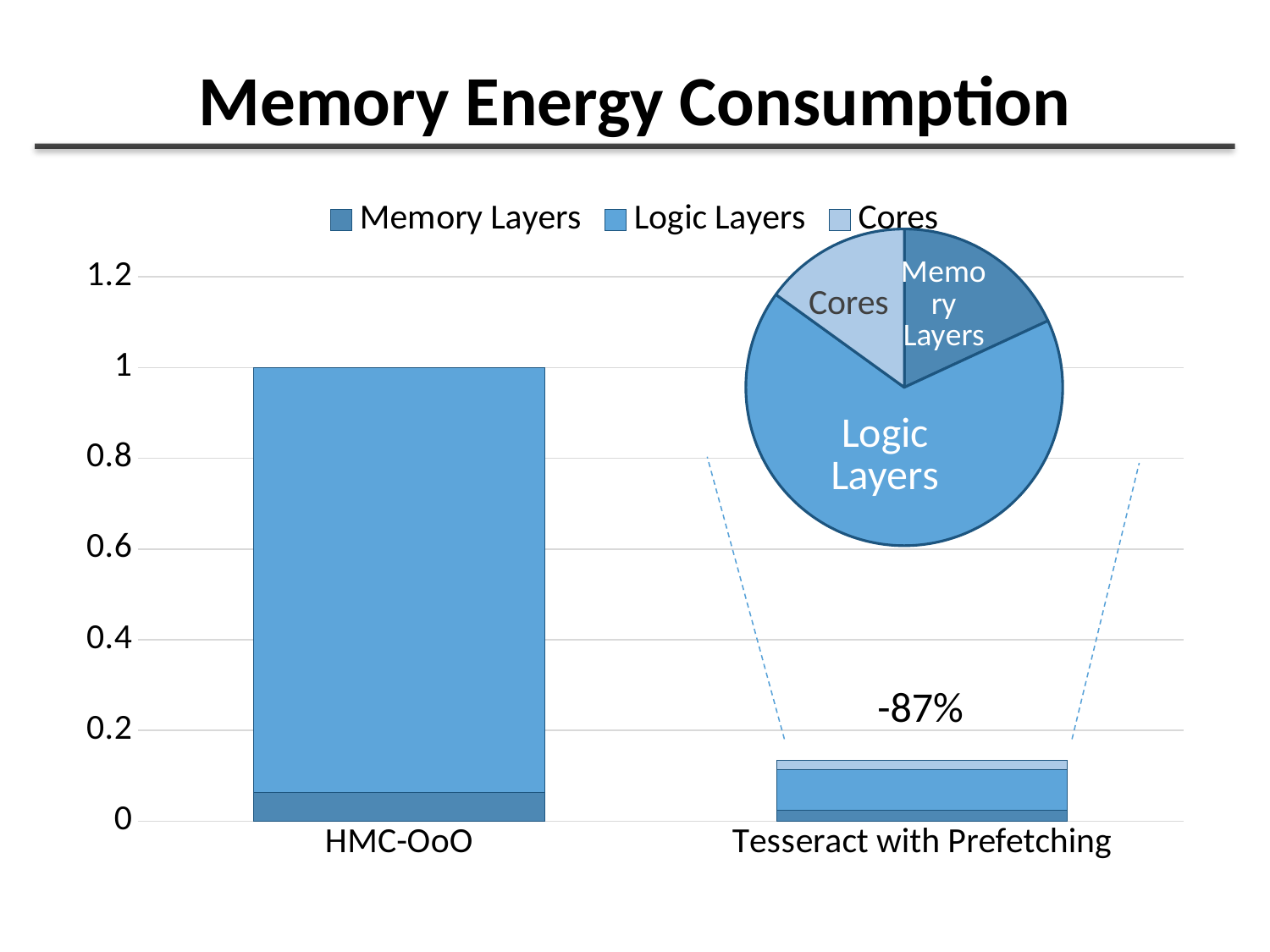
In the bar chart, is the total value for Tesseract with Prefetching greater or less than 0.2? less What kind of chart is the main chart on the slide? Stacked bar chart How many series does the legend of the bar chart list? 3 What percentage change is annotated above the Tesseract with Prefetching bar? -87% In the bar chart, is the Memory Layers value for HMC-OoO greater or less than 0.2? less In the bar chart, which category has the highest total memory energy consumption? HMC-OoO In the pie chart inset, which slice is the largest? Logic Layers How many categories are shown on the x axis of the bar chart? 2 In the bar chart, what is the total value of the HMC-OoO bar? 1 Do the bar totals rise or fall from left to right along the x axis? Fall In the bar chart, which is larger: the total for HMC-OoO or the total for Tesseract with Prefetching? HMC-OoO In the bar chart, which category has the lowest total memory energy consumption? Tesseract with Prefetching